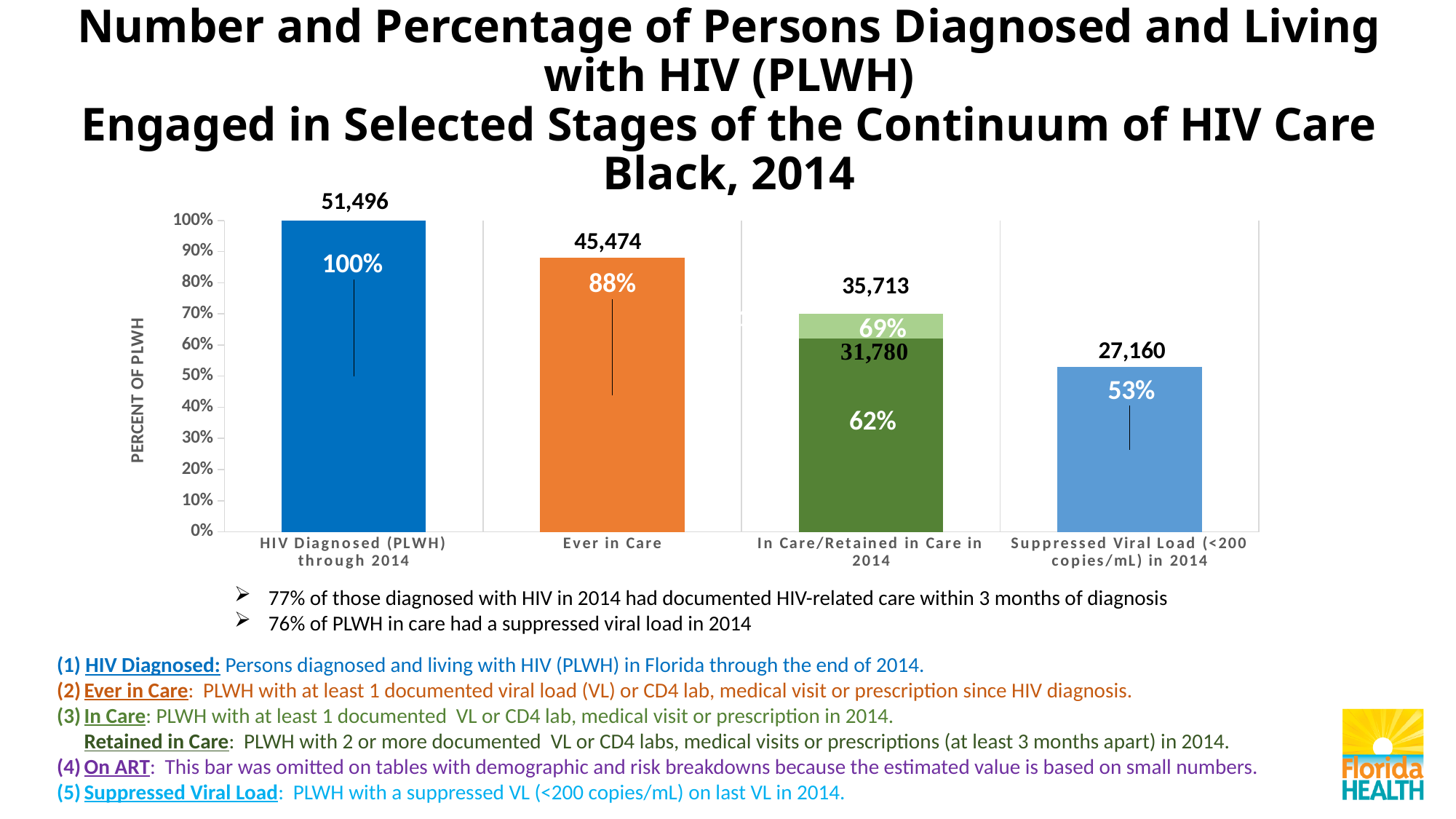
Which category has the highest number of persons? HIV Diagnosed (PLWH) through 2014 What percentage is shown on the Ever in Care bar? 88% What number is labelled above the In Care/Retained in Care in 2014 bar? 35,713 What number is shown for the Retained in Care portion (darker green) of the In Care/Retained in Care bar? 31,780 What kind of chart is shown on the slide? bar chart Which is larger, the percentage for Ever in Care or the percentage for In Care/Retained in Care in 2014? Ever in Care What is the difference in number of persons between Ever in Care and Suppressed Viral Load (<200 copies/mL) in 2014? 18,314 What number is labelled above the bar for HIV Diagnosed (PLWH) through 2014? 51,496 How many categories are shown on the x axis of the chart? 4 What percentage is shown on the Suppressed Viral Load (<200 copies/mL) in 2014 bar? 53% Which category has the lowest percentage of PLWH? Suppressed Viral Load (<200 copies/mL) in 2014 Do the bar values rise or fall from left to right along the x axis? fall